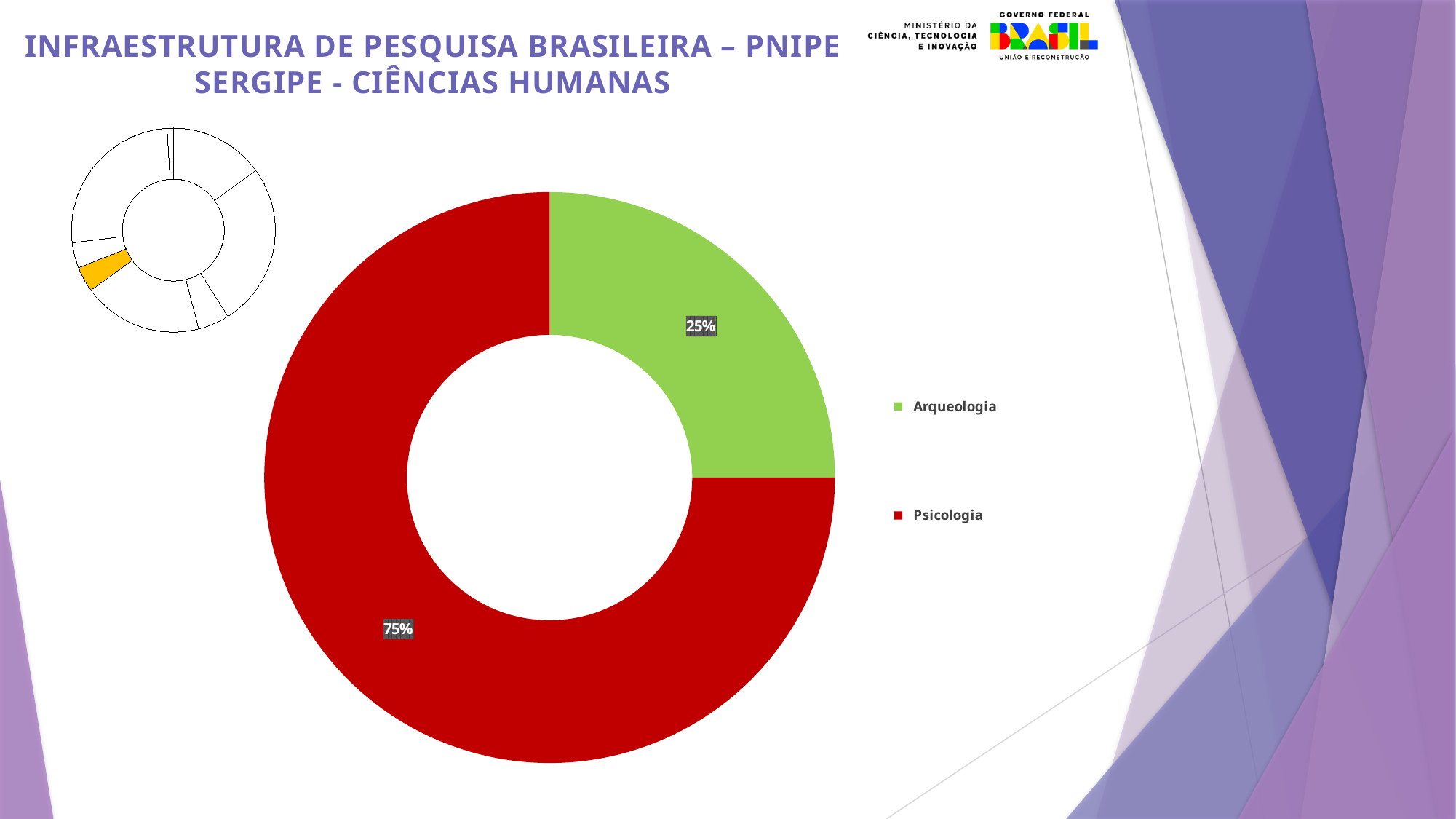
In the large doughnut chart, what is the combined share of Arqueologia and Psicologia? 100% In the large doughnut chart, what colour is the Arqueologia slice? Green In the large doughnut chart, what share is shown for Arqueologia? 25% What kind of chart is the large chart in the centre of the slide? Doughnut chart In the large doughnut chart, what colour is the Psicologia slice? Red In the large doughnut chart, what is the difference in percentage points between Psicologia and Arqueologia? 50 In the large doughnut chart, which category has the largest share? Psicologia How many categories does the legend of the large doughnut chart list? 2 In the large doughnut chart, is the share for Psicologia greater or less than 50%? greater In the large doughnut chart, what share is shown for Psicologia? 75% In the large doughnut chart, which category has the smallest share? Arqueologia In the large doughnut chart, which is larger: the share for Arqueologia or the share for Psicologia? Psicologia